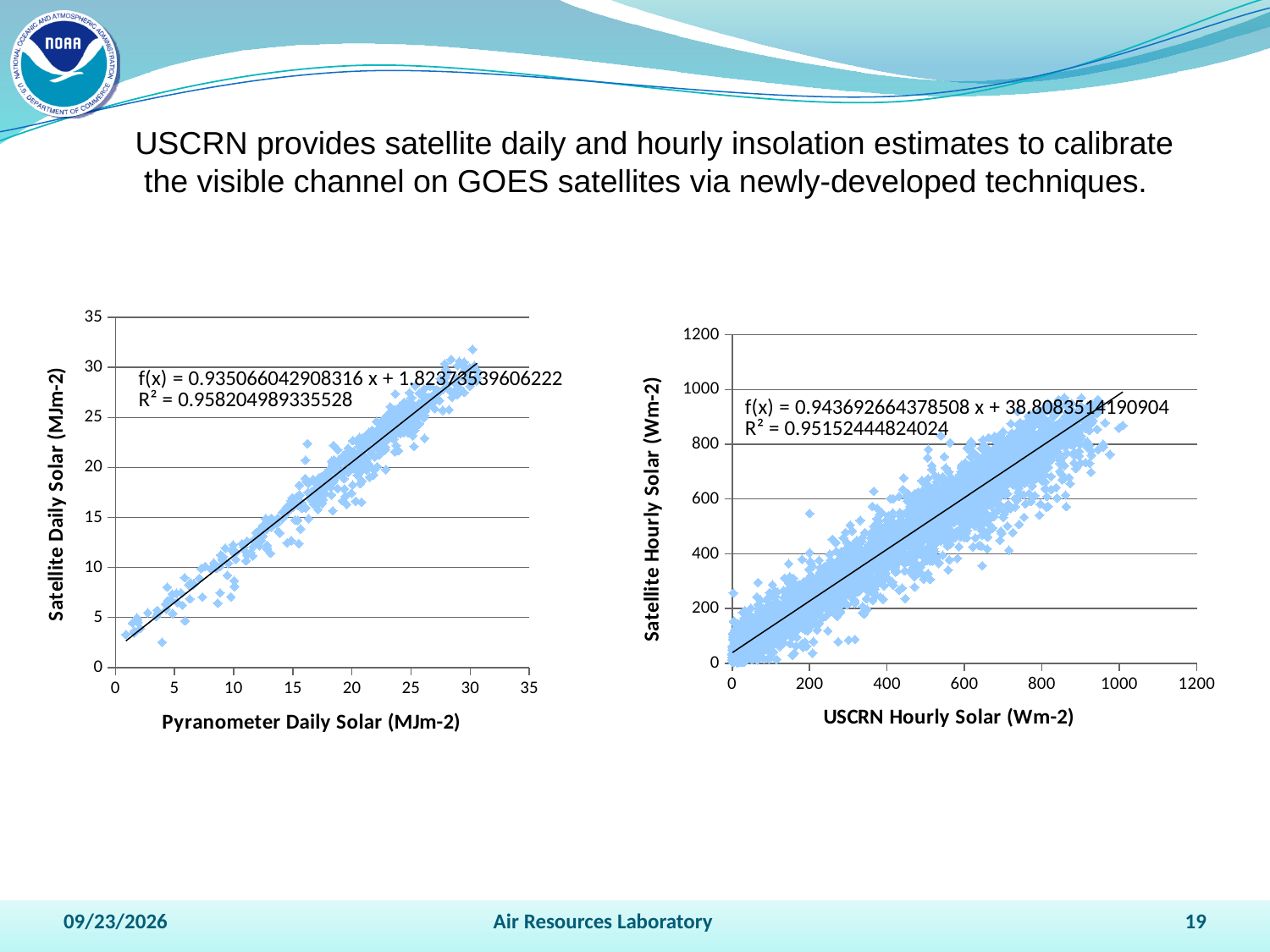
What kind of chart is the left chart, with Pyranometer Daily Solar on the x axis? scatter chart What R² value is printed on the left chart (Satellite Daily Solar vs Pyranometer Daily Solar)? 0.958204989335528 What R² value is printed on the right chart (Satellite Hourly Solar vs USCRN Hourly Solar)? 0.95152444824024 What is the slope of the fitted line printed on the right chart (Satellite Hourly Solar vs USCRN Hourly Solar)? 0.943692664378508 Which chart shows the higher R² value, the left daily chart or the right hourly chart? the left daily chart What is the label of the x axis on the left chart? Pyranometer Daily Solar (MJm-2) What is the label of the y axis on the right chart? Satellite Hourly Solar (Wm-2) In the right chart, do the Satellite Hourly Solar values rise or fall as USCRN Hourly Solar increases? rise What kind of chart is the right chart, with USCRN Hourly Solar on the x axis? scatter chart In the left chart, do the Satellite Daily Solar values rise or fall as Pyranometer Daily Solar increases? rise What is the slope of the fitted line printed on the left chart (Satellite Daily Solar vs Pyranometer Daily Solar)? 0.935066042908316 What is the intercept of the fitted line printed on the right chart (Satellite Hourly Solar vs USCRN Hourly Solar)? 38.8083514190904